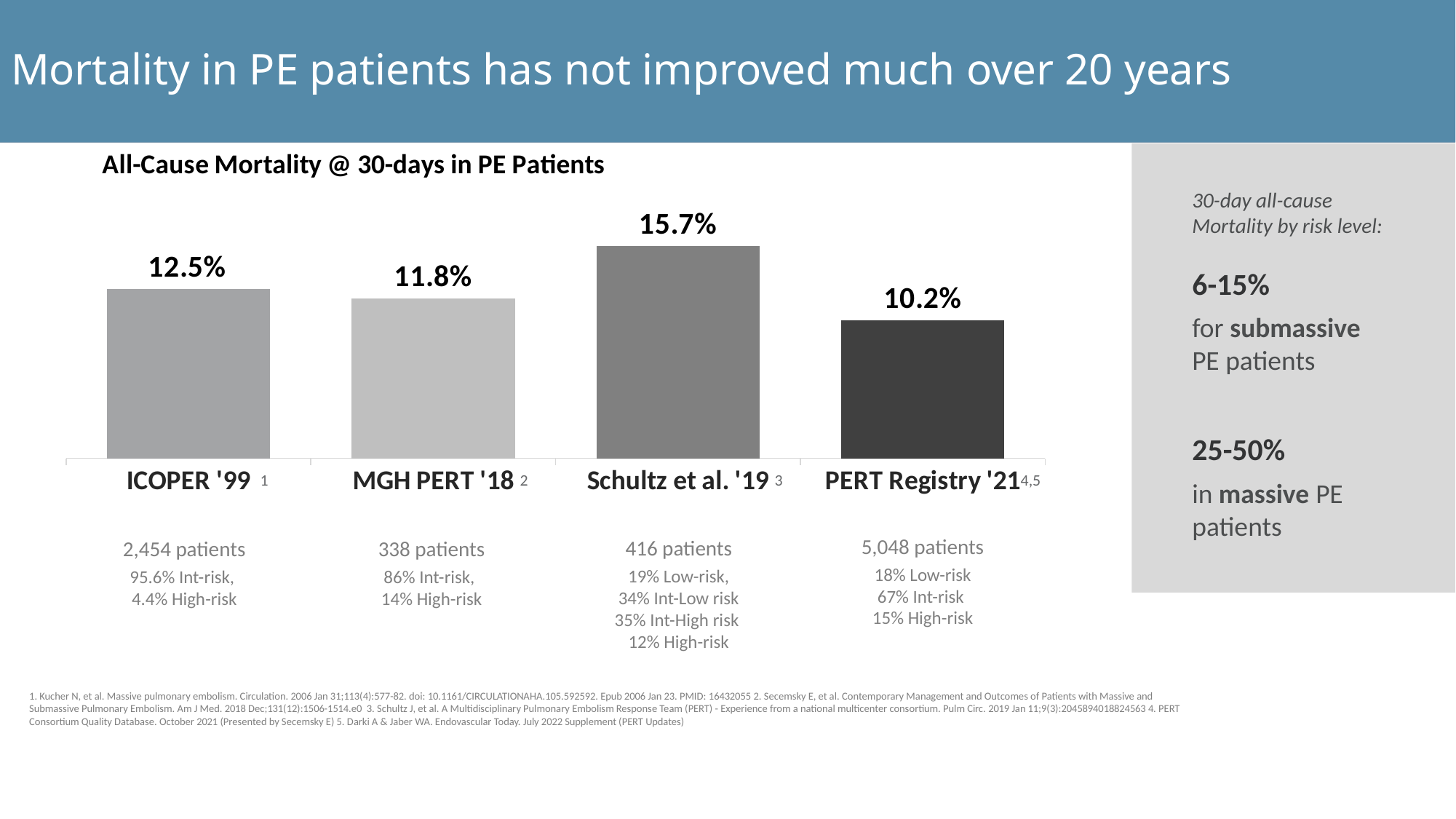
What is the difference in 30-day mortality between ICOPER '99 and MGH PERT '18? 0.7% What is the title of the chart? All-Cause Mortality @ 30-days in PE Patients What is the 30-day all-cause mortality for PERT Registry '21? 10.2% Which study has the lowest 30-day all-cause mortality? PERT Registry '21 What is the 30-day all-cause mortality for ICOPER '99? 12.5% What is the 30-day all-cause mortality for Schultz et al. '19? 15.7% What type of chart is used to show all-cause mortality? Bar chart What is the difference in 30-day mortality between Schultz et al. '19 and PERT Registry '21? 5.5% Which has a higher 30-day mortality, ICOPER '99 or PERT Registry '21? ICOPER '99 Which study has the highest 30-day all-cause mortality? Schultz et al. '19 How many studies are shown as bars in the chart? 4 What is the 30-day all-cause mortality for MGH PERT '18? 11.8%